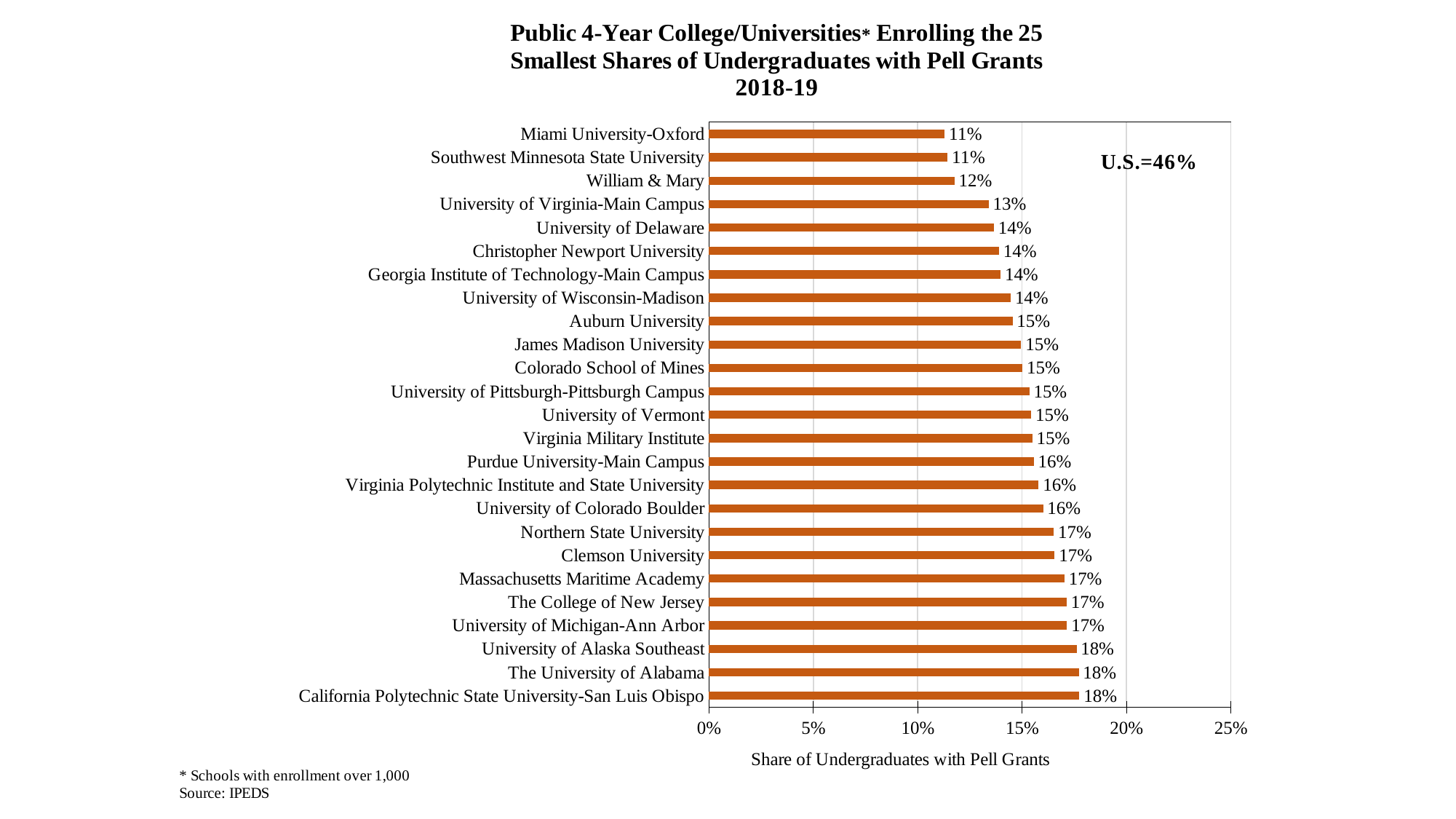
What is the share of undergraduates with Pell Grants at William & Mary? 12% What is the lowest share of undergraduates with Pell Grants shown on the chart? 11% What is the share of undergraduates with Pell Grants at the University of Michigan-Ann Arbor? 17% What is the share of undergraduates with Pell Grants at Purdue University-Main Campus? 16% What kind of chart is shown on the slide? Bar chart How many colleges/universities are listed on the chart? 25 What U.S. share of undergraduates with Pell Grants is noted on the chart? 46% What is the difference in percentage points between California Polytechnic State University-San Luis Obispo and Miami University-Oxford? 7 percentage points Is the value for Miami University-Oxford greater or less than 15%? less What is the highest share of undergraduates with Pell Grants shown on the chart? 18% What is the share of undergraduates with Pell Grants at the University of Virginia-Main Campus? 13% Which has a larger share of undergraduates with Pell Grants, Clemson University or William & Mary? Clemson University